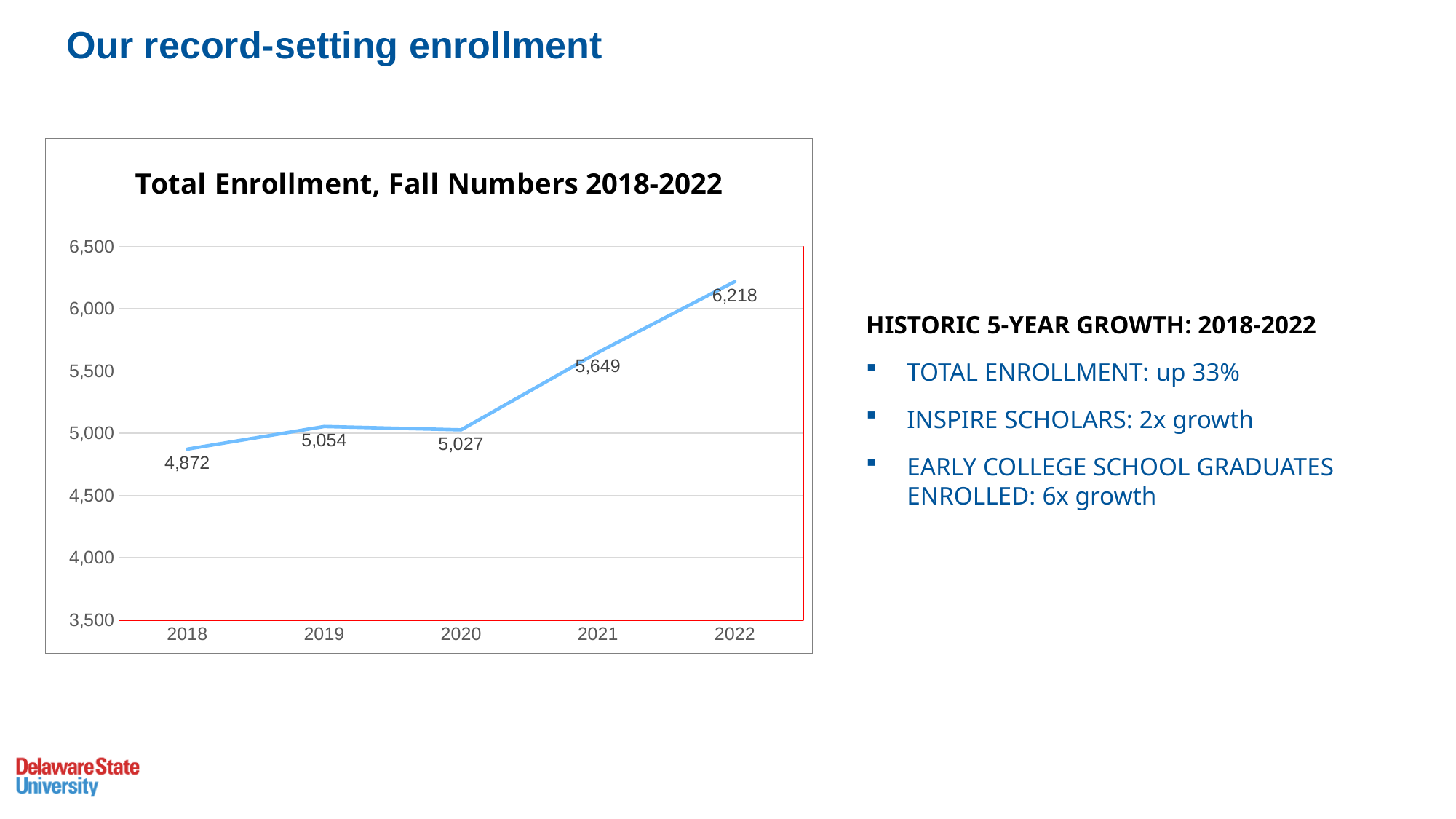
What kind of chart is shown on the slide? line chart What was the total enrollment in 2018? 4,872 Which year had higher total enrollment, 2021 or 2020? 2021 What was the total enrollment in 2022? 6,218 Which year had the highest total enrollment? 2022 What is the difference in total enrollment between 2022 and 2021? 569 What is the title of the chart? Total Enrollment, Fall Numbers 2018-2022 Which year had the lowest total enrollment? 2018 How many years are plotted on the chart? 5 What is the difference in total enrollment between 2019 and 2020? 27 Is the total enrollment for 2021 greater or less than 5,500? greater What was the total enrollment in 2020? 5,027